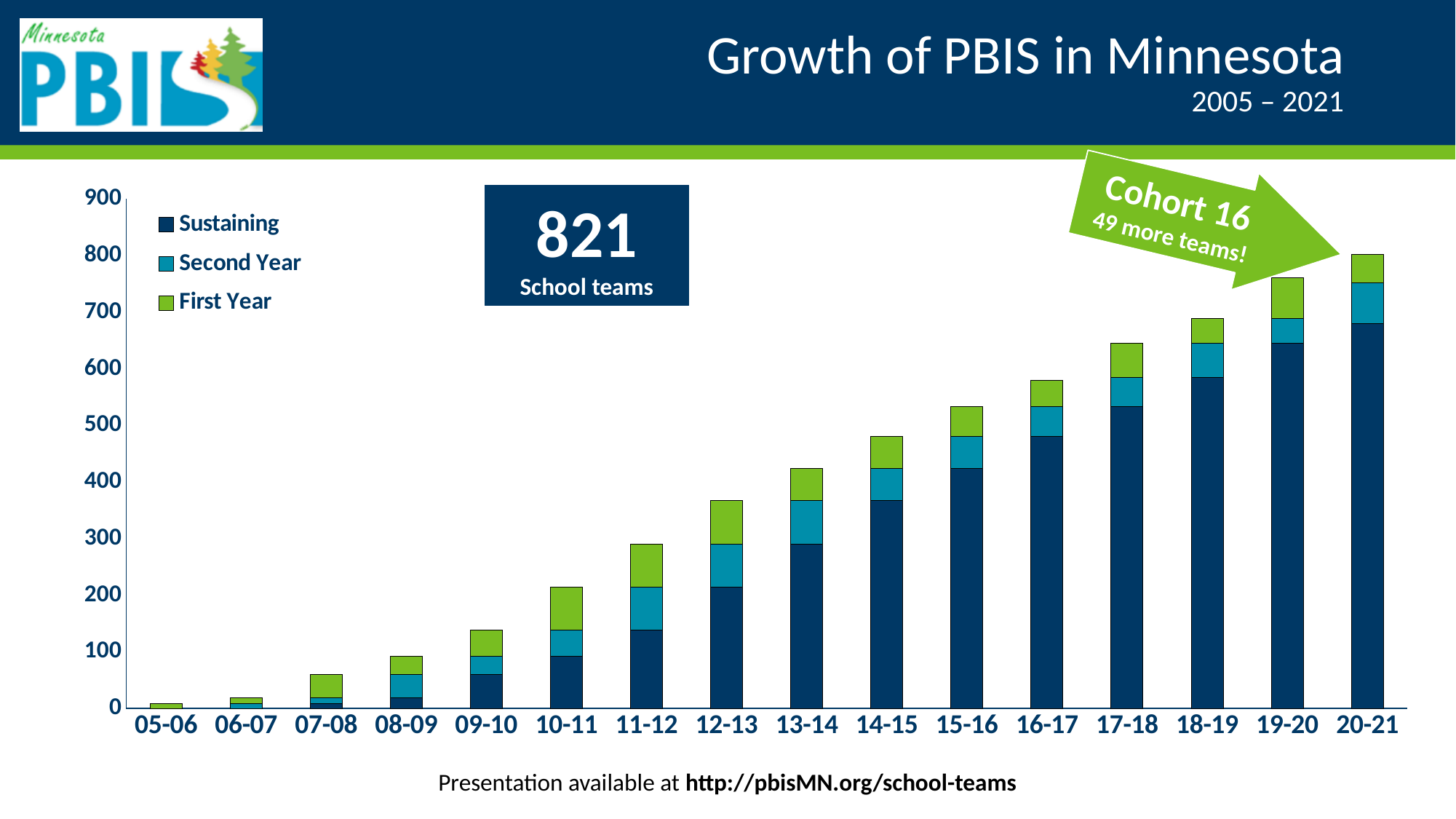
Which has the taller stacked bar, 18-19 or 19-20? 19-20 Do the total bar heights rise or fall from 05-06 to 20-21? Rise How many school-year categories are shown on the x axis? 16 How many series does the legend list? 3 Is the total bar height for 17-18 greater or less than 600? greater Which legend entry is shown in green? First Year Is the total bar height for 10-11 greater or less than 300? less What is the title of the chart on the slide? Growth of PBIS in Minnesota Is the total bar height for 20-21 greater or less than 700? greater What kind of chart is shown on the slide? Stacked bar chart Which school year has the shortest stacked bar? 05-06 Which school year has the tallest stacked bar? 20-21